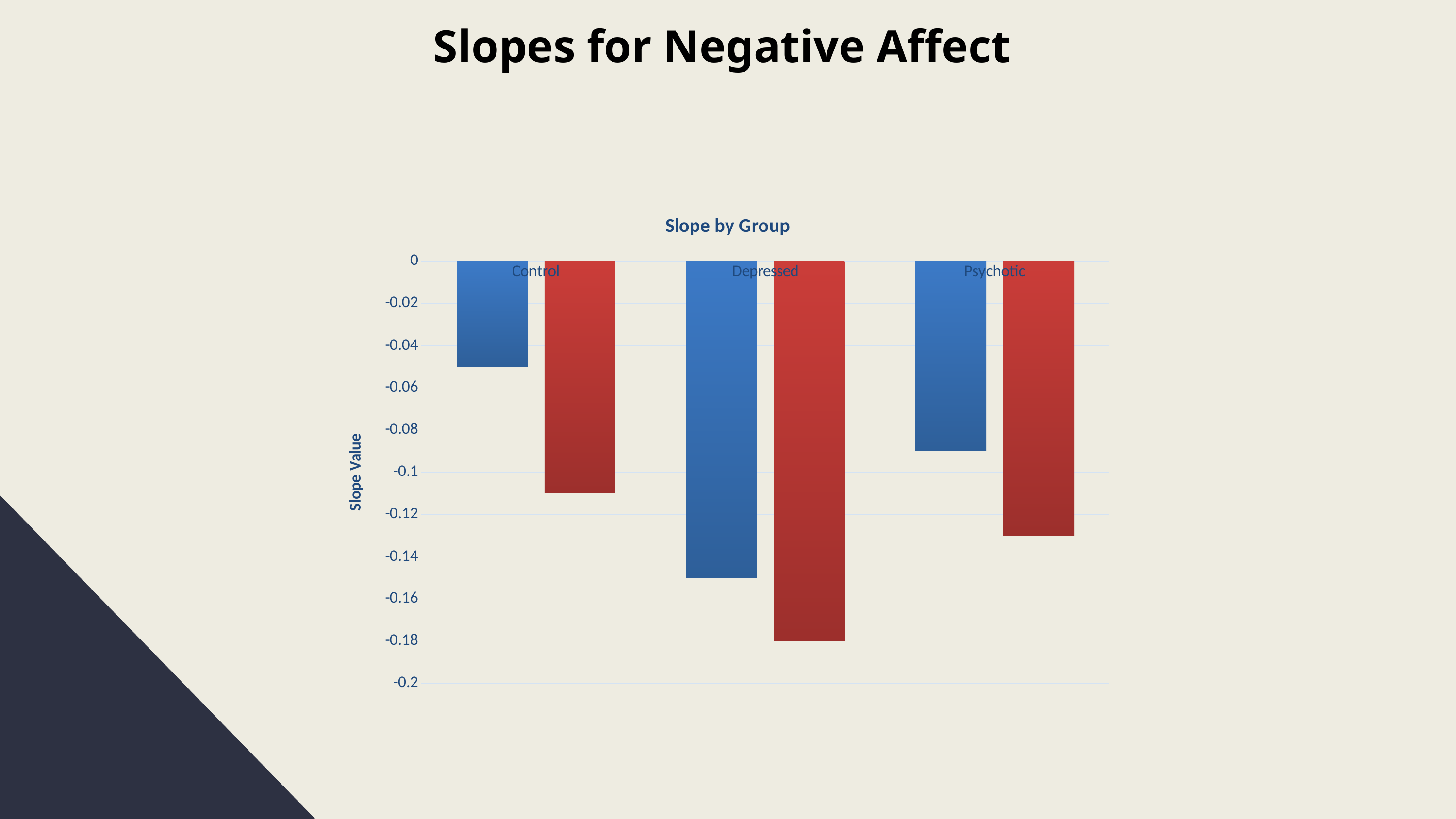
What is the value of the red bar for Depressed? -0.18 What is the title of the chart? Slope by Group How many groups are shown on the x axis of the chart? 3 What is the label on the vertical axis of the chart? Slope Value How many bars are plotted for each group in the chart? 2 Which is lower, the blue bar for Depressed or the blue bar for Psychotic? Depressed Which group has the lowest (most negative) slope value in the chart? Depressed Is the value of the red bar for Control greater or less than -0.1? less Is the value of the blue bar for Psychotic greater or less than -0.1? greater Is the value of the blue bar for Depressed greater or less than -0.1? less Which group has the highest (least negative) slope value in the chart? Control What kind of chart is shown on the slide? bar chart